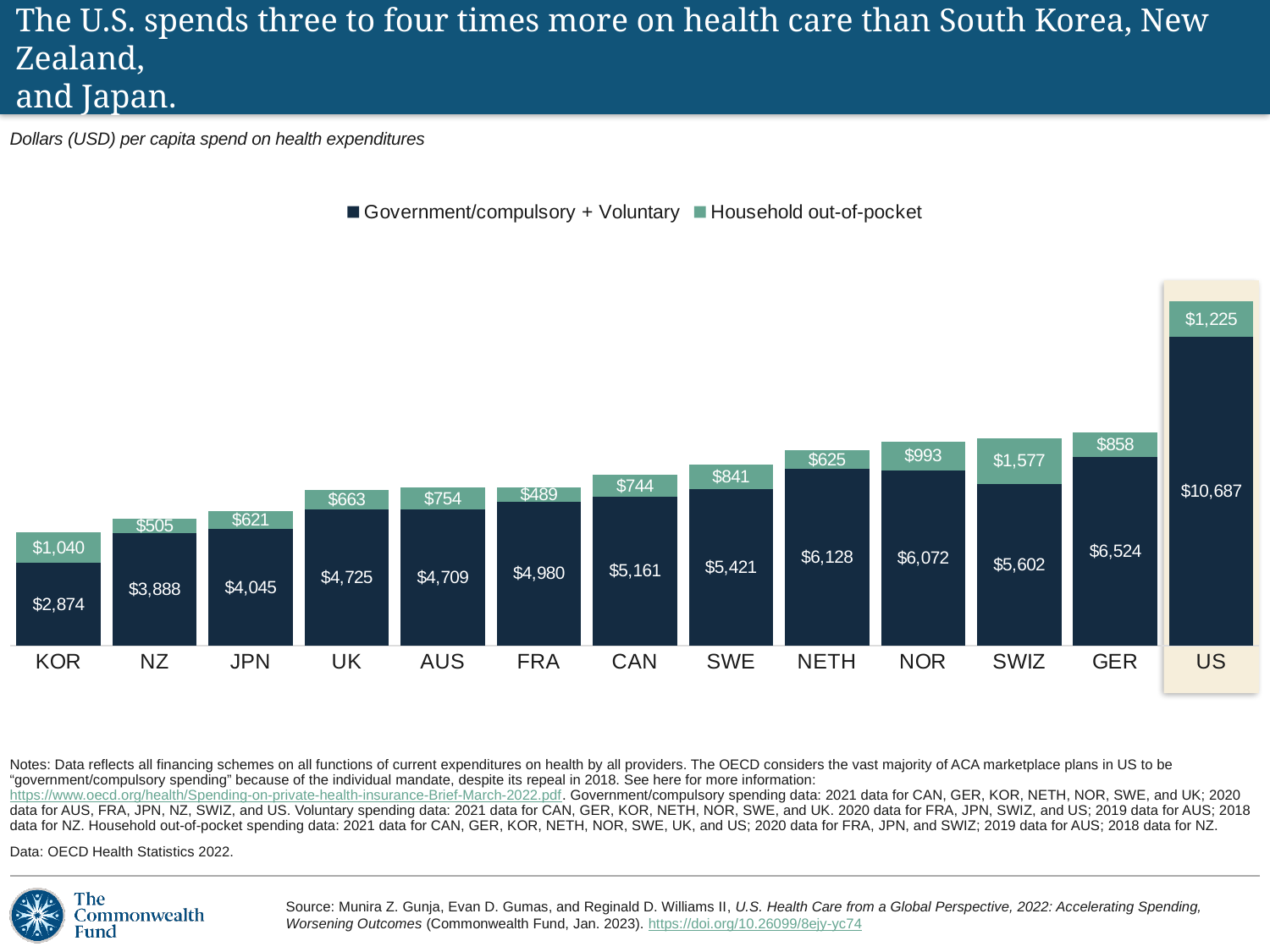
How many countries are shown on the chart? 13 What is the Household out-of-pocket spending per capita for SWIZ? $1,577 Which country has the highest Government/compulsory + Voluntary spending per capita? US What is the total per capita health spending for KOR, combining both series? $3,914 What is the total per capita health spending for the US, combining both series? $11,912 How many series does the legend list? 2 What is the difference between the Government/compulsory + Voluntary spending of GER and NOR? $452 What kind of chart is shown on the slide? Stacked bar chart Which country has the lowest Household out-of-pocket spending per capita? FRA Which has a larger Household out-of-pocket spending per capita, NOR or NETH? NOR What is the Government/compulsory + Voluntary spending per capita for KOR? $2,874 What is the Government/compulsory + Voluntary spending per capita for the US? $10,687